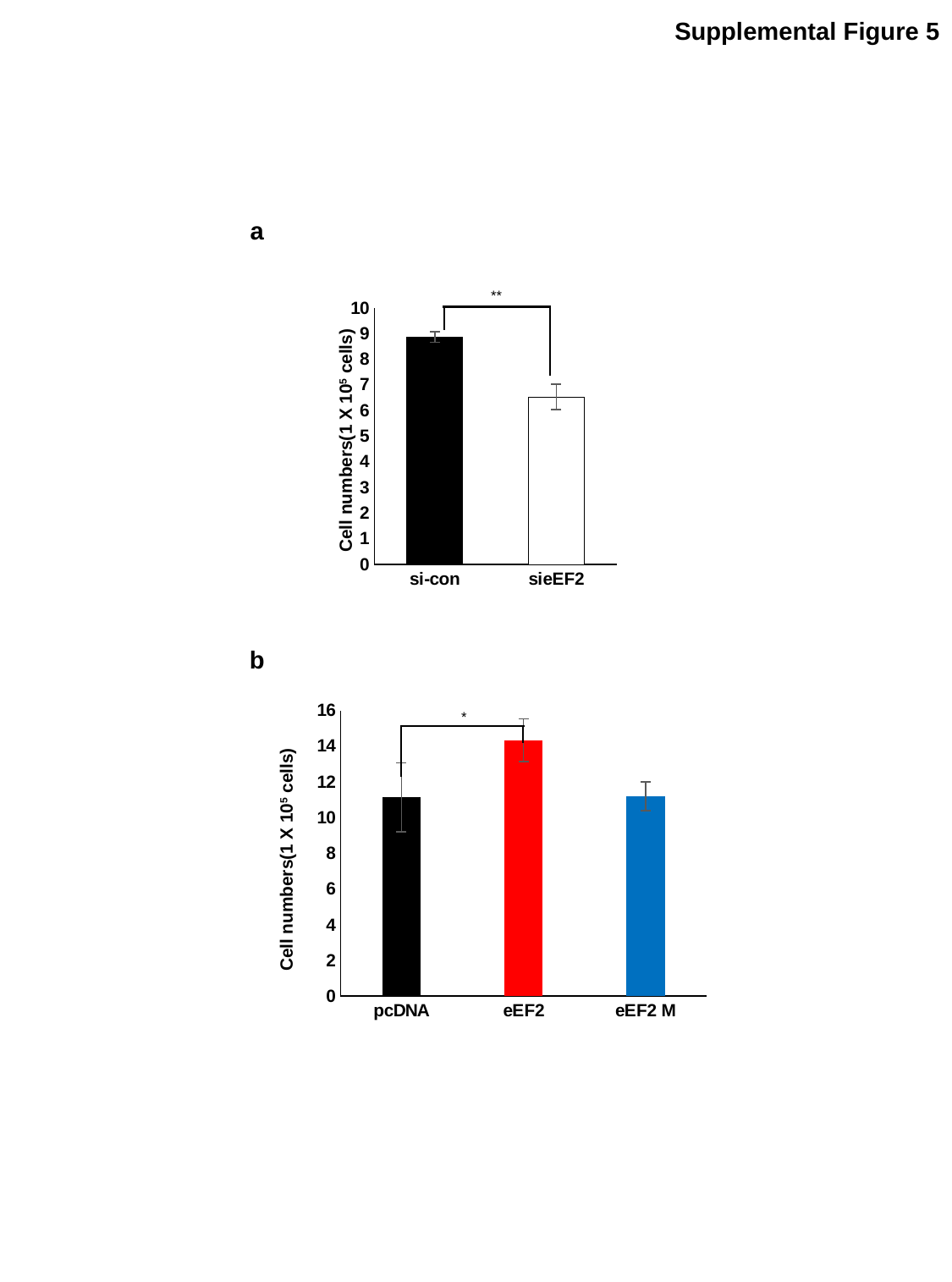
In the bottom chart (panel b), is the value for pcDNA greater or less than 12? less In the top chart (panel a), is the value for si-con greater or less than 8? greater In the top chart (panel a), which category has the highest value? si-con In the top chart (panel a), what kind of chart is shown? bar chart In the bottom chart (panel b), is the value for eEF2 greater or less than 14? greater In the top chart (panel a), which category has the lowest value? sieEF2 In the bottom chart (panel b), how many categories are plotted on the x axis? 3 In the top chart (panel a), what is the y-axis label? Cell numbers(1 X 10⁵ cells) In the bottom chart (panel b), what colour is the bar for eEF2? red In the top chart (panel a), how many categories are plotted on the x axis? 2 In the bottom chart (panel b), which category has the highest value? eEF2